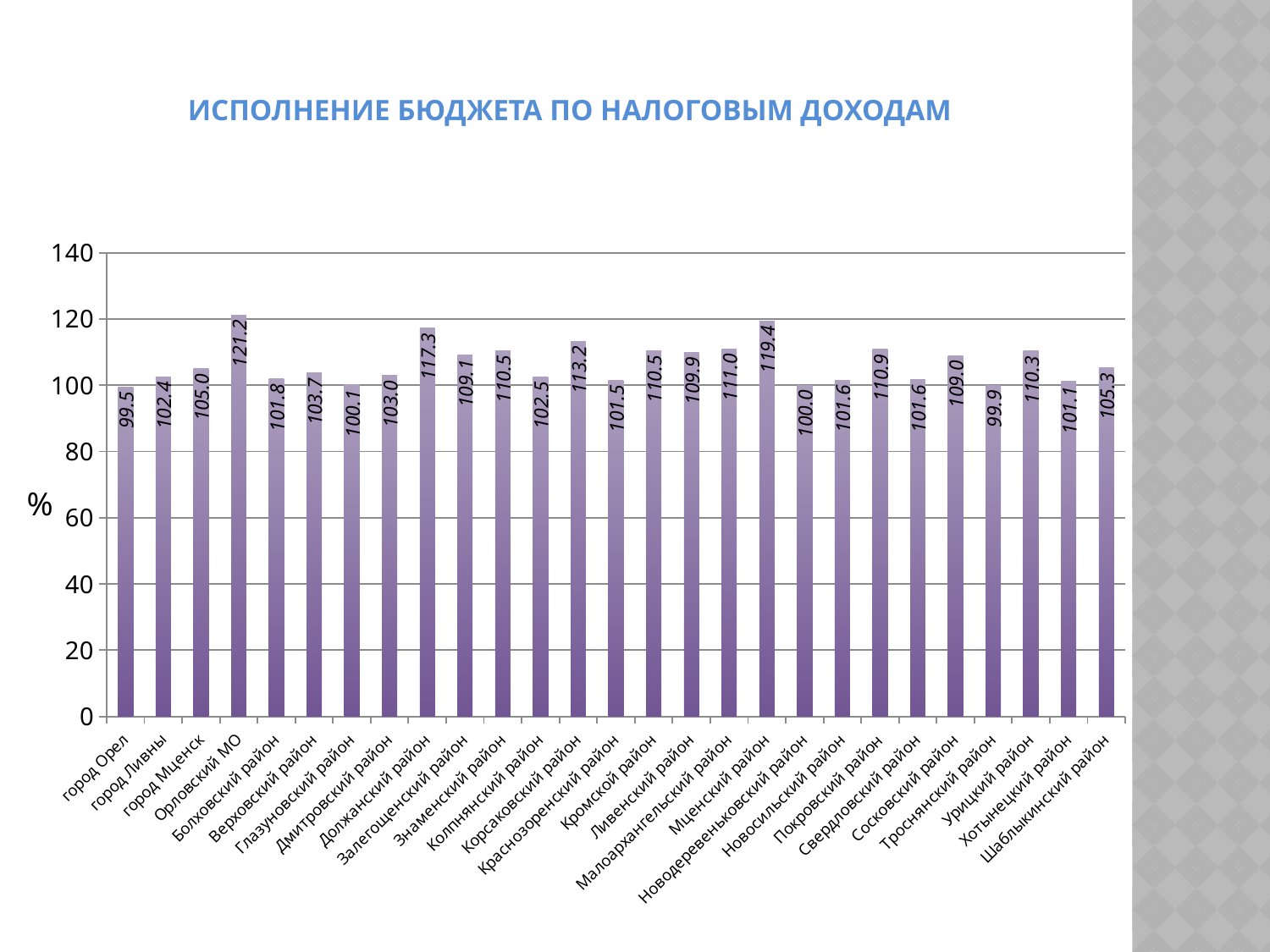
What is the title of the chart? ИСПОЛНЕНИЕ БЮДЖЕТА ПО НАЛОГОВЫМ ДОХОДАМ Which is larger, the value for Должанский район or the value for Корсаковский район? Должанский район Is the value for Новодеревеньковский район greater or less than 120? less What is the value for Мценский район? 119.4 What is the value for Шаблыкинский район? 105.3 What type of chart is shown on the slide? bar chart How many categories are shown on the x axis? 27 Which category has the lowest value? город Орел What is the difference between the values for Орловский МО and Мценский район? 1.8 What is the value for Орловский МО? 121.2 Which category has the highest value? Орловский МО What is the value for город Орел? 99.5